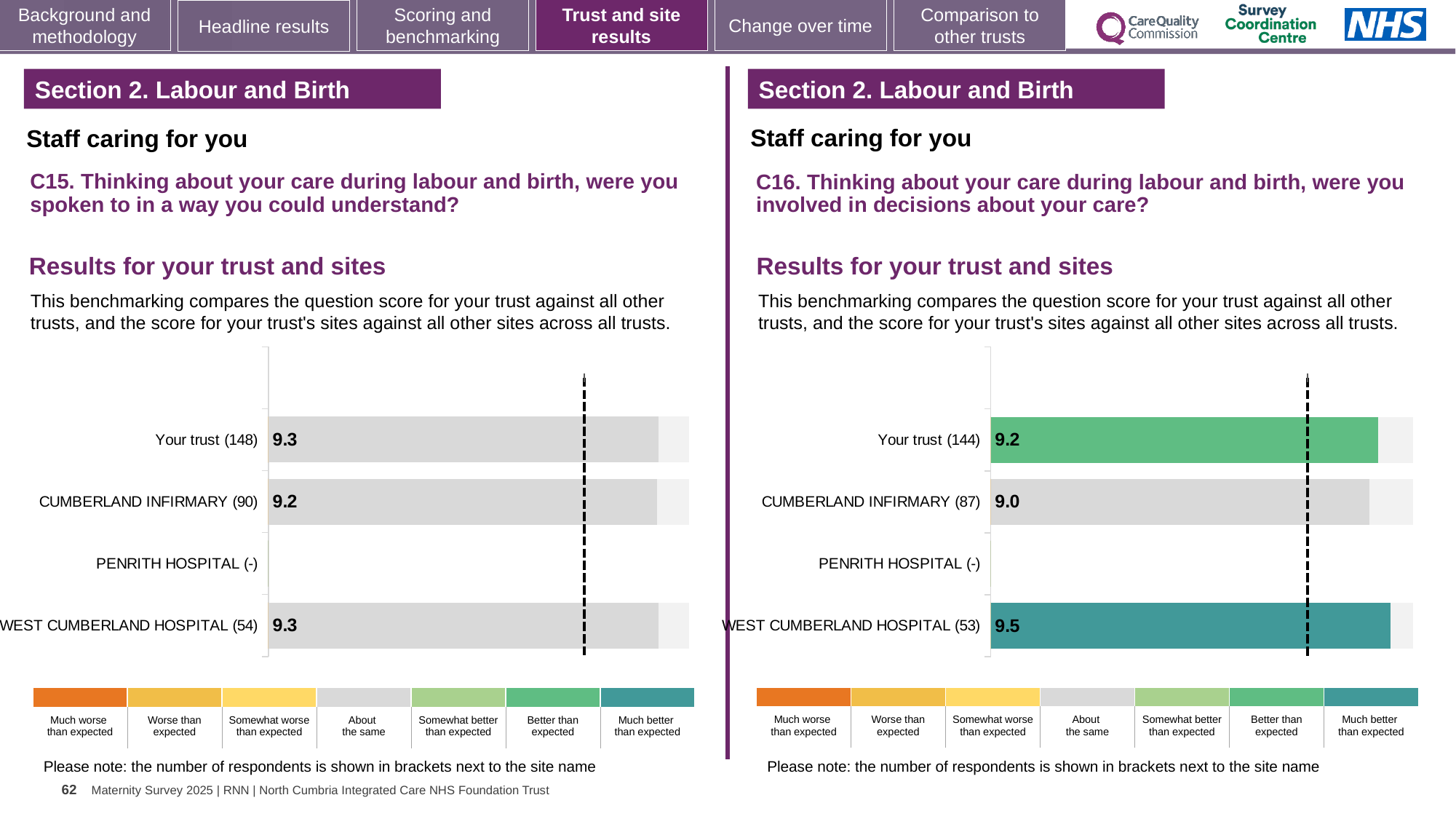
In the C16 chart on the right, which site or trust has the highest score? West Cumberland Hospital In the C16 chart on the right, what is the score for Cumberland Infirmary? 9.0 What kind of chart is used in the C16 chart on the right? Bar chart In the C16 chart on the right, how many respondents are shown in brackets for Your trust? 144 In the C15 chart on the left, what is the score for Cumberland Infirmary? 9.2 How many categories (trust and sites) are listed in the C15 chart on the left? 4 In the C16 chart on the right, what is the score for West Cumberland Hospital? 9.5 In the C16 chart on the right, which site or trust has the lowest score shown? Cumberland Infirmary In the C16 chart on the right, what is the difference between the scores for West Cumberland Hospital and Cumberland Infirmary? 0.5 In the C16 chart on the right, which has the higher score, Your trust or West Cumberland Hospital? West Cumberland Hospital In the C15 chart on the left, what is the score for Your trust? 9.3 In the C15 chart on the left, which has the higher score, Your trust or Cumberland Infirmary? Your trust